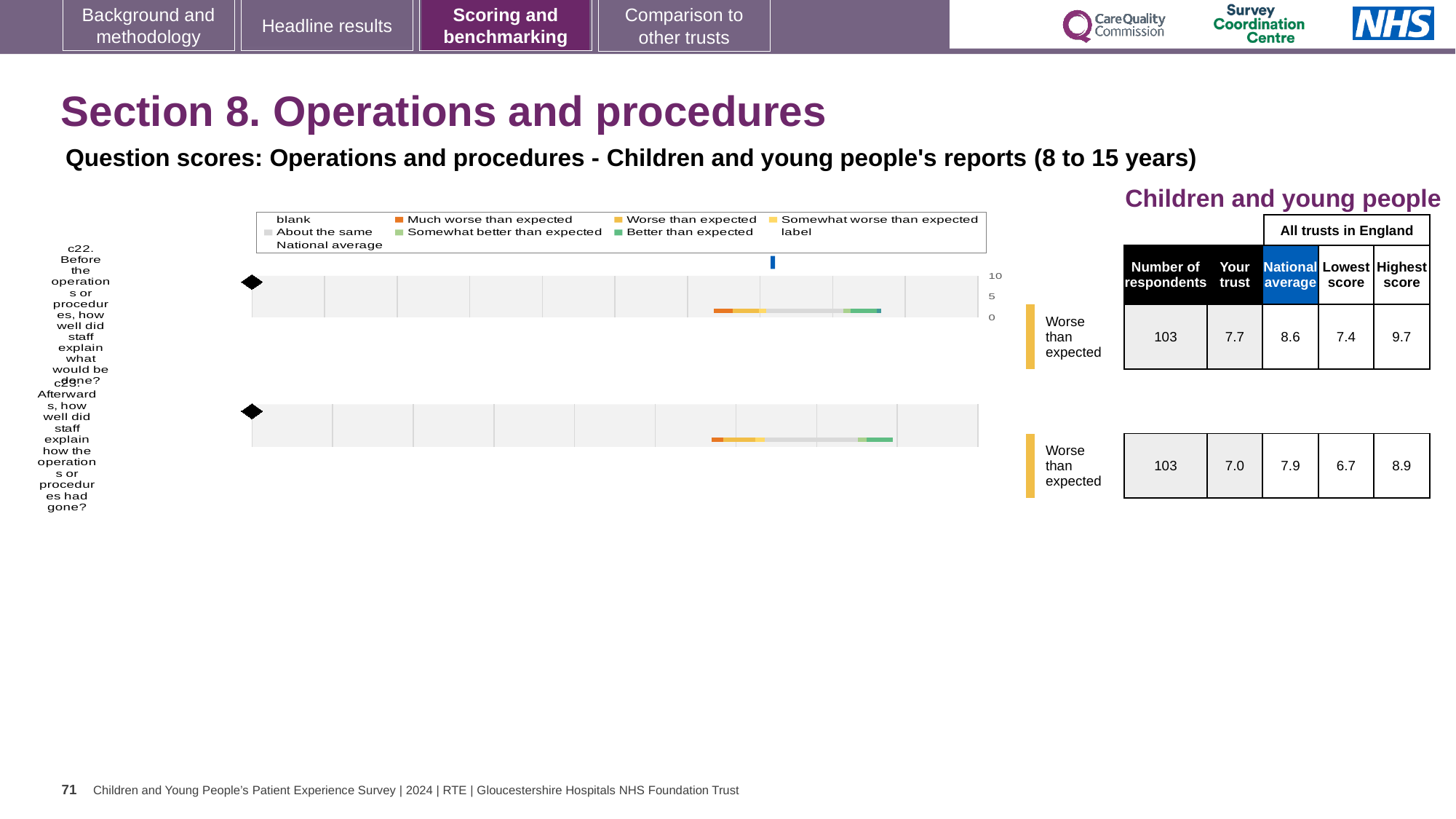
What is the 'Your trust' score for question c23 (Afterwards, how well did staff explain how the operations or procedures had gone?)? 7.0 What is the 'Your trust' score for question c22 (Before the operations or procedures, how well did staff explain what would be done?)? 7.7 How many respondents answered question c22? 103 What is the difference between the national average and the 'Your trust' score for question c22? 0.9 What kind of chart is used to show the question scores on this slide? bar chart What is the difference between the highest and lowest scores for question c23? 2.2 Which question has the higher 'Your trust' score, c22 or c23? c22 What benchmark category is shown for question c22? Worse than expected What is the highest score among all trusts in England for question c23? 8.9 How many questions (bars) are plotted in the chart? 2 Is the 'Your trust' score for question c23 greater or less than 5? greater What is the national average score for question c22? 8.6